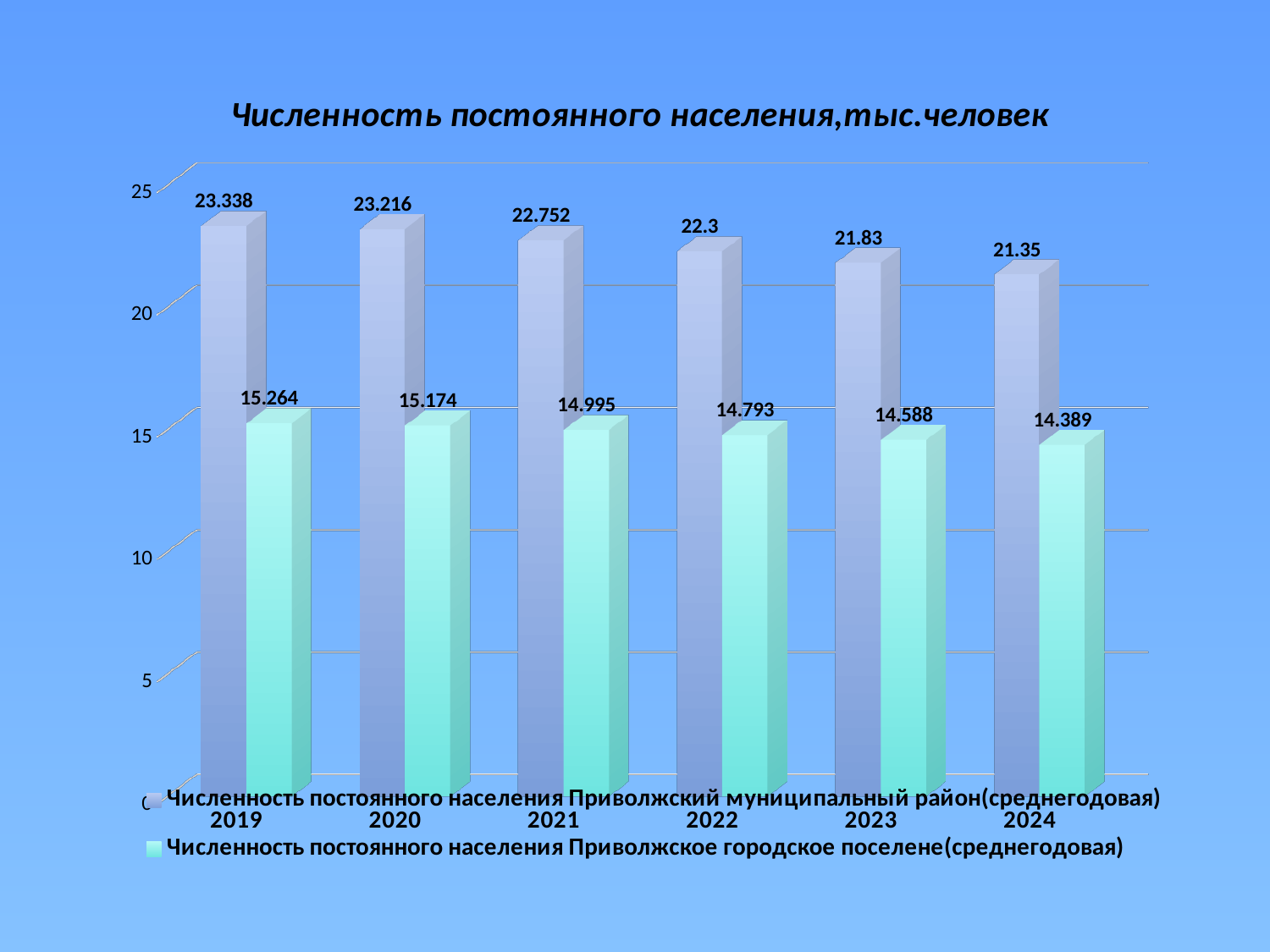
Is the 2023 value for 'Численность постоянного населения Приволжское городское поселене(среднегодовая)' greater or less than 15? less How many years are shown on the x axis? 6 What is the difference between the two series' values for 2019? 8.074 By how much did the value for 'Численность постоянного населения Приволжский муниципальный район(среднегодовая)' fall from 2019 to 2024? 1.988 Which year has the highest value in the series 'Численность постоянного населения Приволжское городское поселене(среднегодовая)'? 2019 What is the value for 2019 in the series 'Численность постоянного населения Приволжский муниципальный район(среднегодовая)'? 23.338 Which is larger: the 2021 value for the district series or the 2021 value for the urban settlement series? The district series (22.752) How many series does the legend list? 2 Which year has the lowest value in the series 'Численность постоянного населения Приволжский муниципальный район(среднегодовая)'? 2024 What kind of chart is shown on the slide? Bar chart What is the value for 2024 in the series 'Численность постоянного населения Приволжское городское поселене(среднегодовая)'? 14.389 What is the value for 2022 in the series 'Численность постоянного населения Приволжский муниципальный район(среднегодовая)'? 22.3